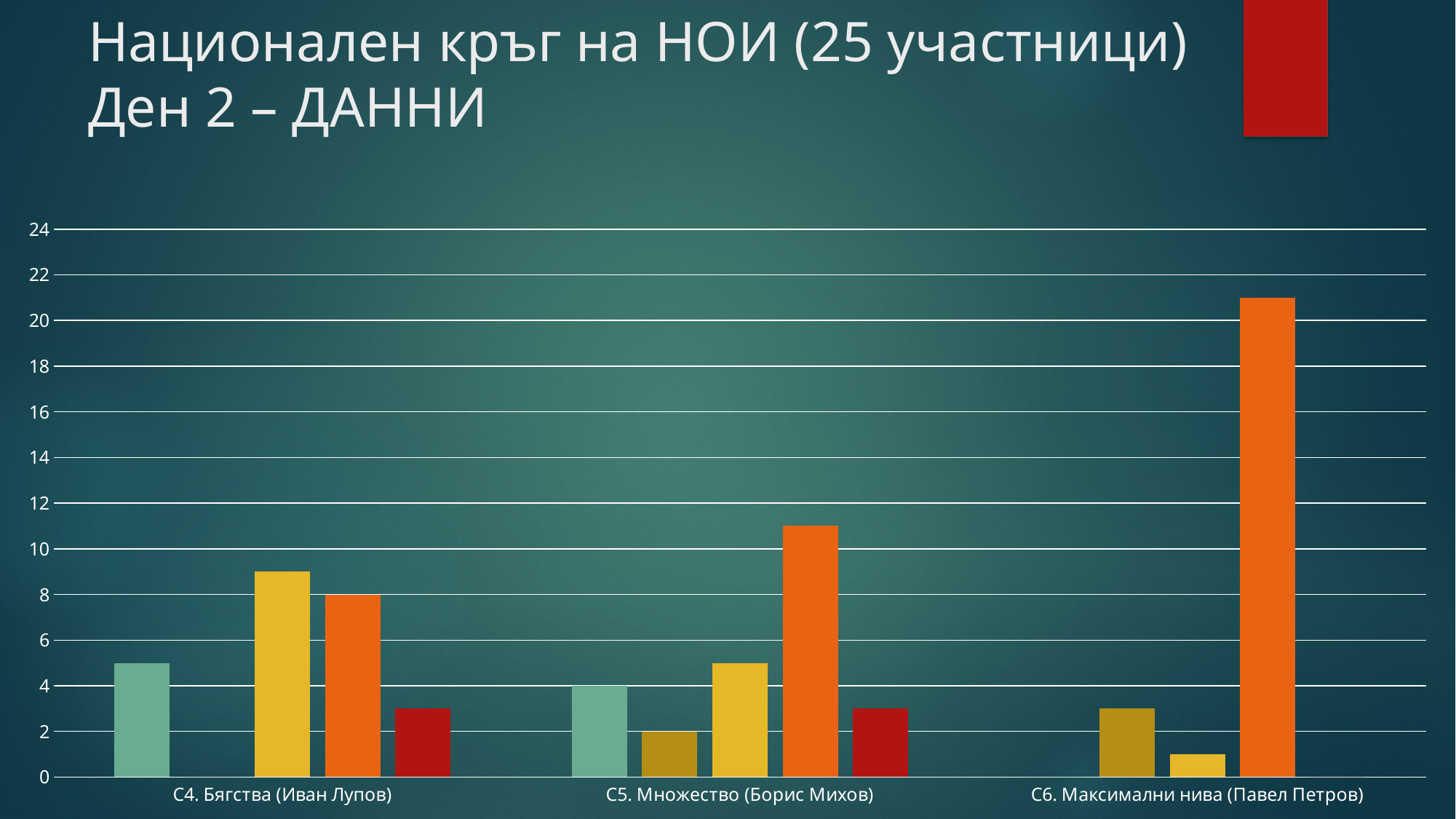
How many categories are shown on the x axis of the chart? 3 What is the value of the orange bar for C4. Бягства (Иван Лупов)? 8 Which category contains the tallest bar in the chart? C6. Максимални нива (Павел Петров) Is the value of the red bar for C4. Бягства (Иван Лупов) greater or less than 4? less Is the value of the orange bar for C6. Максимални нива (Павел Петров) greater or less than 20? greater Which bar is the tallest within the C5. Множество (Борис Михов) group? the orange bar What is the value of the teal bar for C5. Множество (Борис Михов)? 4 What is the title of the slide? Национален кръг на НОИ (25 участници) Ден 2 – ДАННИ What is the value of the olive bar for C5. Множество (Борис Михов)? 2 Is the value of the orange bar for C5. Множество (Борис Михов) greater or less than 10? greater Which is larger: the orange bar for C6. Максимални нива (Павел Петров) or the orange bar for C5. Множество (Борис Михов)? C6. Максимални нива (Павел Петров) What kind of chart is shown on the slide? bar chart